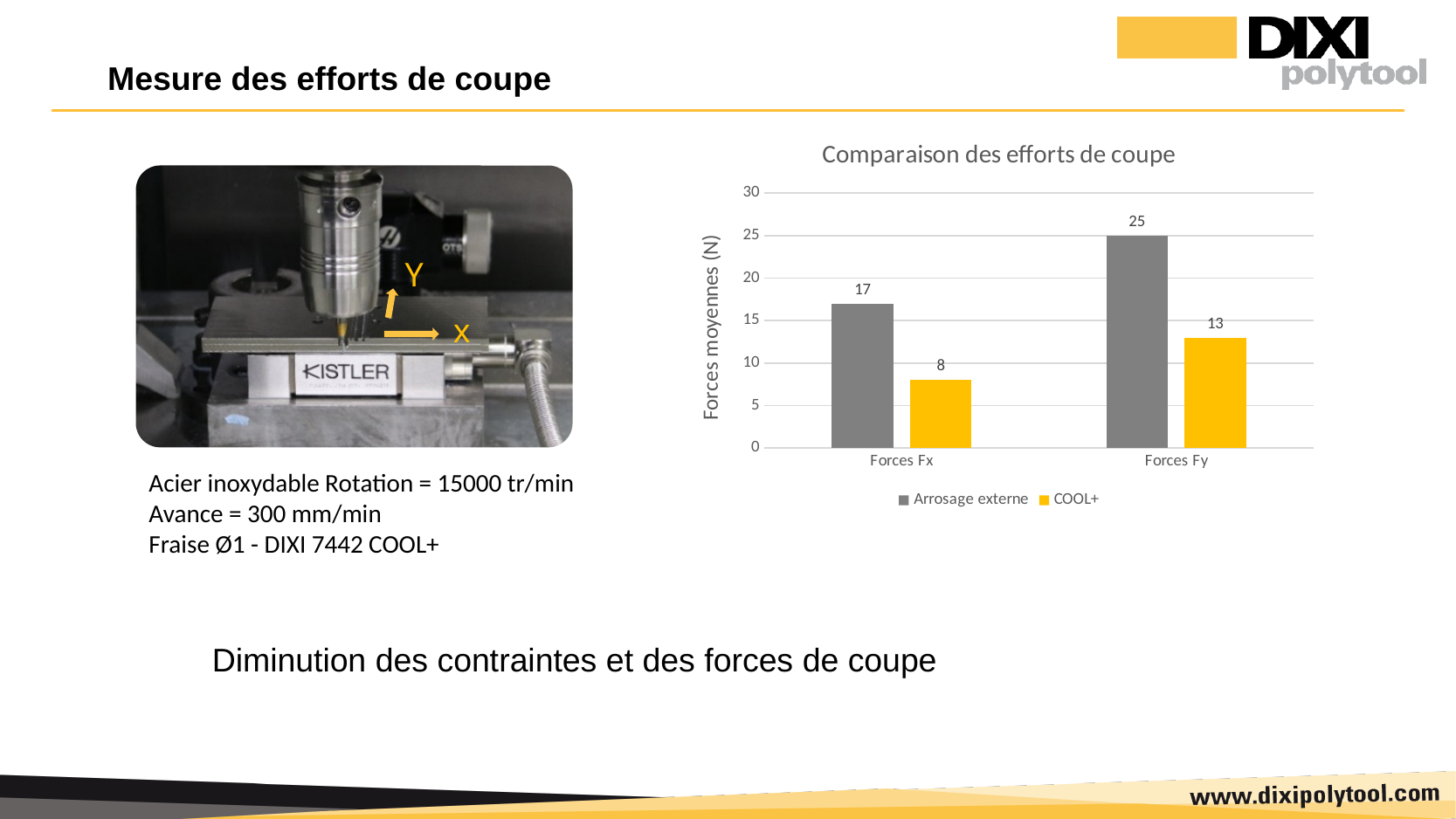
What is the value for Arrosage externe in the Forces Fx category? 17 What is the title of the chart? Comparaison des efforts de coupe What is the value for COOL+ in the Forces Fx category? 8 What is the value for COOL+ in the Forces Fy category? 13 How many categories are shown on the x axis? 2 What is the difference between Arrosage externe and COOL+ in the Forces Fy category? 12 Which is larger in the Forces Fx category, Arrosage externe or COOL+? Arrosage externe How many series does the legend list? 2 What kind of chart is shown on the slide? Bar chart Is the value for Arrosage externe in Forces Fy greater or less than 20? greater Which bar has the highest value in the chart? Arrosage externe, Forces Fy Which bar has the lowest value in the chart? COOL+, Forces Fx